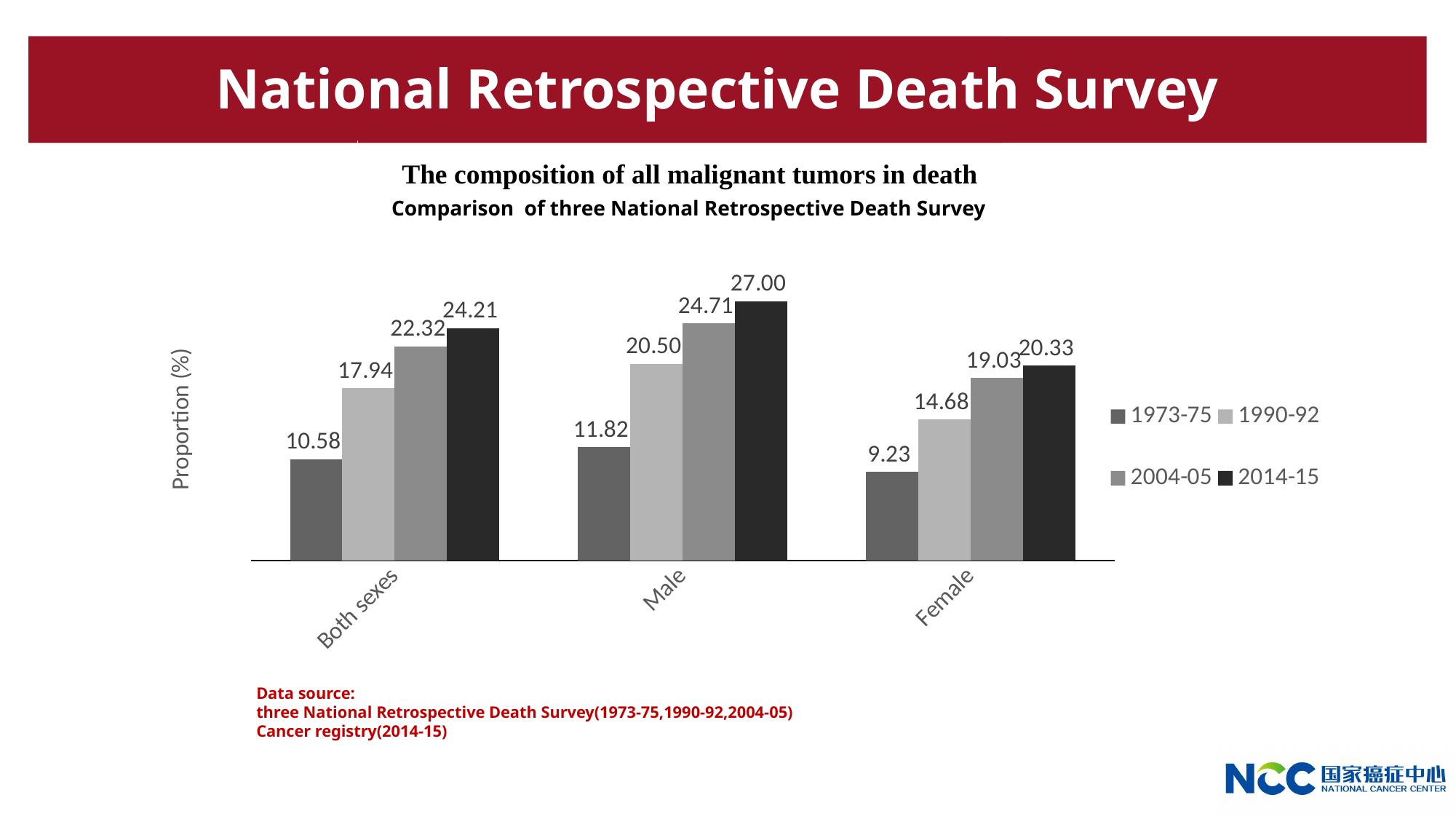
For the Male category, do the values rise or fall from the 1973-75 series to the 2014-15 series? Rise What is the value for Male in the 2014-15 series? 27.00 What kind of chart is shown on the slide? Bar chart Which category has the highest value in the 2004-05 series? Male What is the value for Female in the 1973-75 series? 9.23 Which is larger, the 2004-05 value for Female or the 1990-92 value for Male? 1990-92 value for Male What is the label of the y axis? Proportion (%) What is the value for Both sexes in the 1990-92 series? 17.94 What is the difference between the 2014-15 and 1973-75 values for Both sexes? 13.63 How many series does the legend list? 4 How many categories are shown on the x axis? 3 Which category has the lowest value in the 1973-75 series? Female